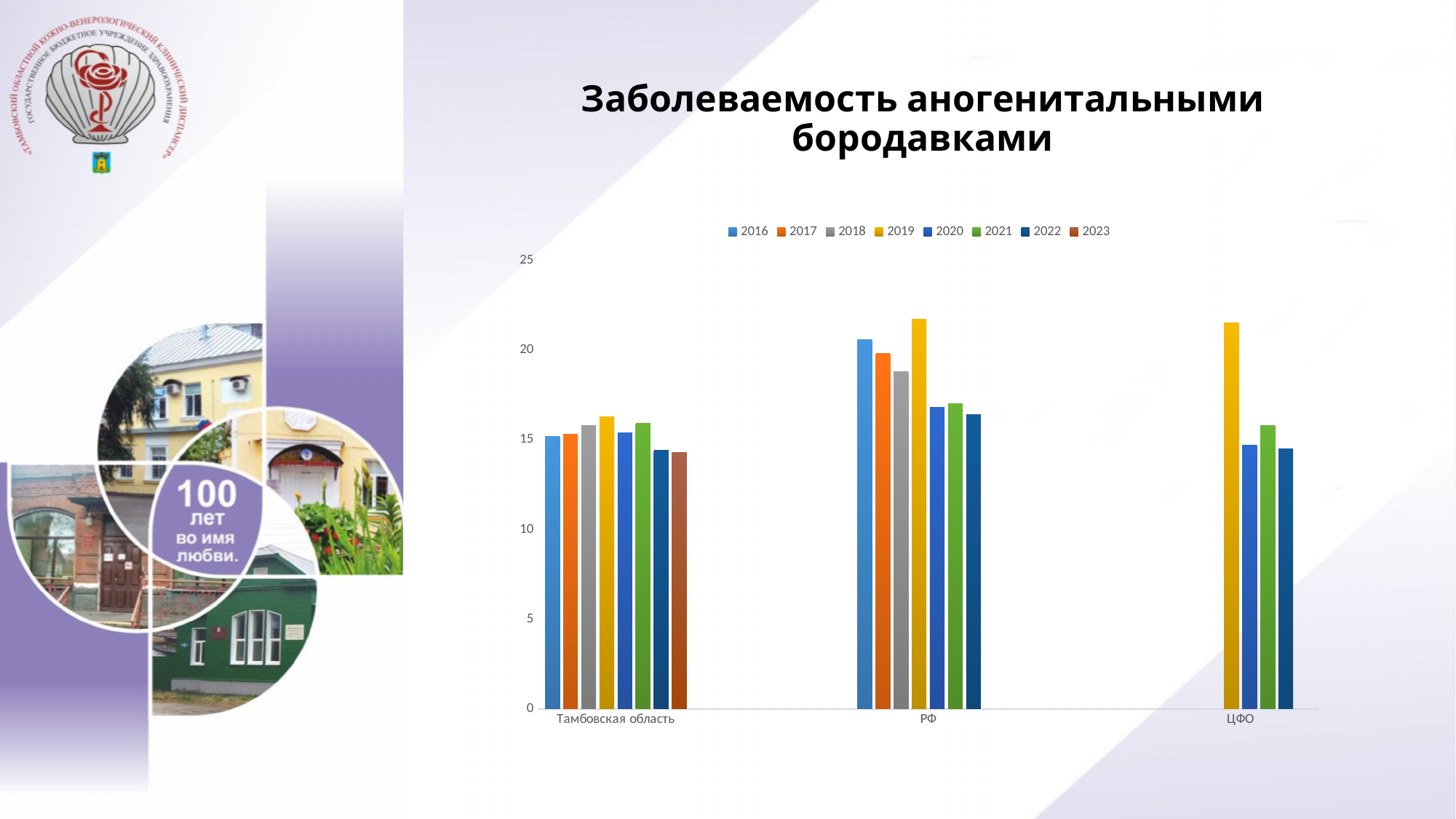
Is the value for Тамбовская область in 2023 greater or less than 15? less For ЦФО, which year has the highest value? 2019 Is the value for РФ in 2019 greater or less than 20? greater For РФ, which year has the highest value? 2019 What kind of chart is shown on the slide? bar chart How many series does the legend list? 8 Which is larger in 2016: the value for РФ or for Тамбовская область? РФ For ЦФО, which is larger: the value for 2020 or for 2021? 2021 Is the value for РФ in 2018 greater or less than 15? greater What is the title of the chart? Заболеваемость аногенитальными бородавками How many categories are shown on the x axis? 3